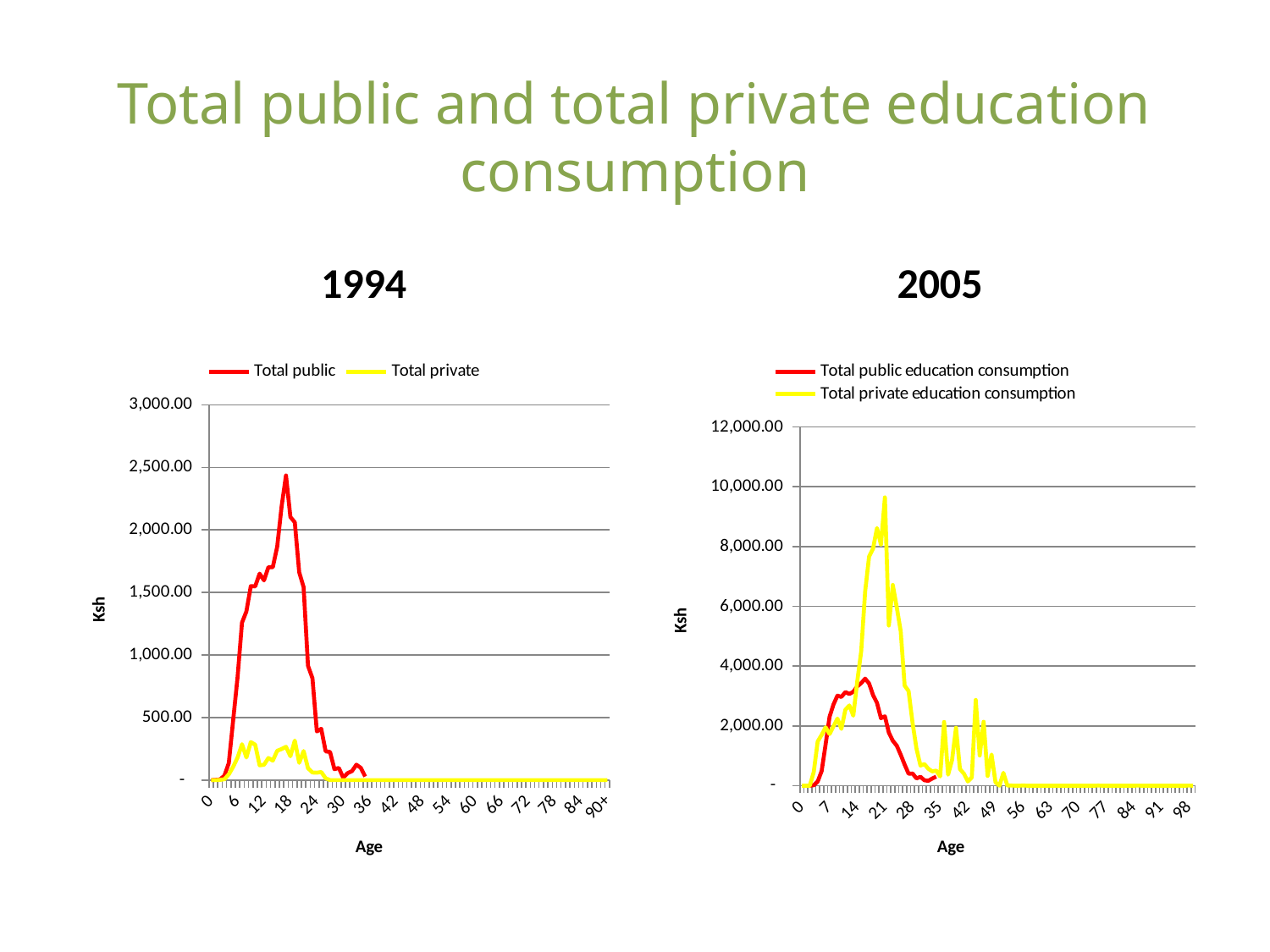
In the 1994 chart, is the peak value of Total public greater or less than 2,000.00? greater In the 2005 chart, which series reaches the higher peak, Total public education consumption or Total private education consumption? Total private education consumption In the 2005 chart, is the peak value of Total private education consumption greater or less than 8,000.00? greater In the 2005 chart, is the peak value of Total public education consumption greater or less than 4,000.00? less What is the label on the vertical axis of the 1994 chart? Ksh How many series does the legend of the 1994 chart list? 2 In the 1994 chart, does the Total public line rise or fall between age 18 and age 30? Fall What kind of chart is the 1994 chart? Line chart How many series does the legend of the 2005 chart list? 2 What is the highest tick value shown on the vertical axis of the 2005 chart? 12,000.00 In the 1994 chart, which series reaches the higher peak, Total public or Total private? Total public